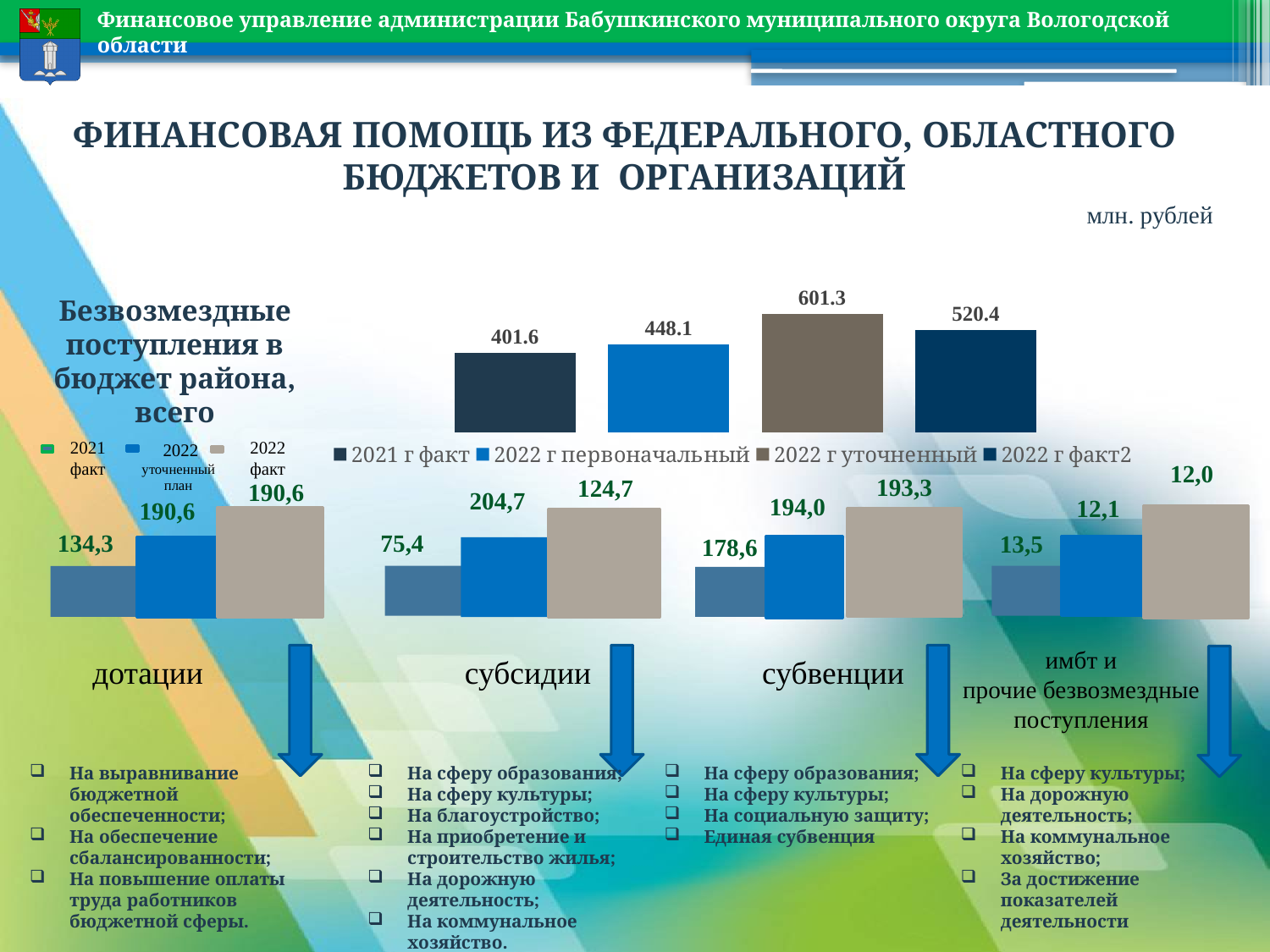
In the chart 'Безвозмездные поступления в бюджет района, всего', which series has the highest value? 2022 г уточненный What type of chart is used for 'Безвозмездные поступления в бюджет района, всего'? Bar chart In the chart 'Безвозмездные поступления в бюджет района, всего', what is the difference between '2022 г уточненный' and '2022 г факт2'? 80.9 In the 'субсидии' chart, what is the value for 2022 уточненный план? 204,7 In the chart 'Безвозмездные поступления в бюджет района, всего', how many series does the legend list? 4 In the 'субвенции' chart, what is the value for 2022 факт? 193,3 In the 'имбт и прочие безвозмездные поступления' chart, which is larger: 2021 факт or 2022 факт? 2021 факт In the chart 'Безвозмездные поступления в бюджет района, всего', what is the value for '2021 г факт'? 401.6 In the 'субсидии' chart, which series has the lowest value? 2021 факт In the 'дотации' chart, what is the value for 2021 факт? 134,3 In the 'субсидии' chart, what is the difference between 2022 уточненный план and 2022 факт? 80,0 In the chart 'Безвозмездные поступления в бюджет района, всего', what is the value for '2022 г уточненный'? 601.3